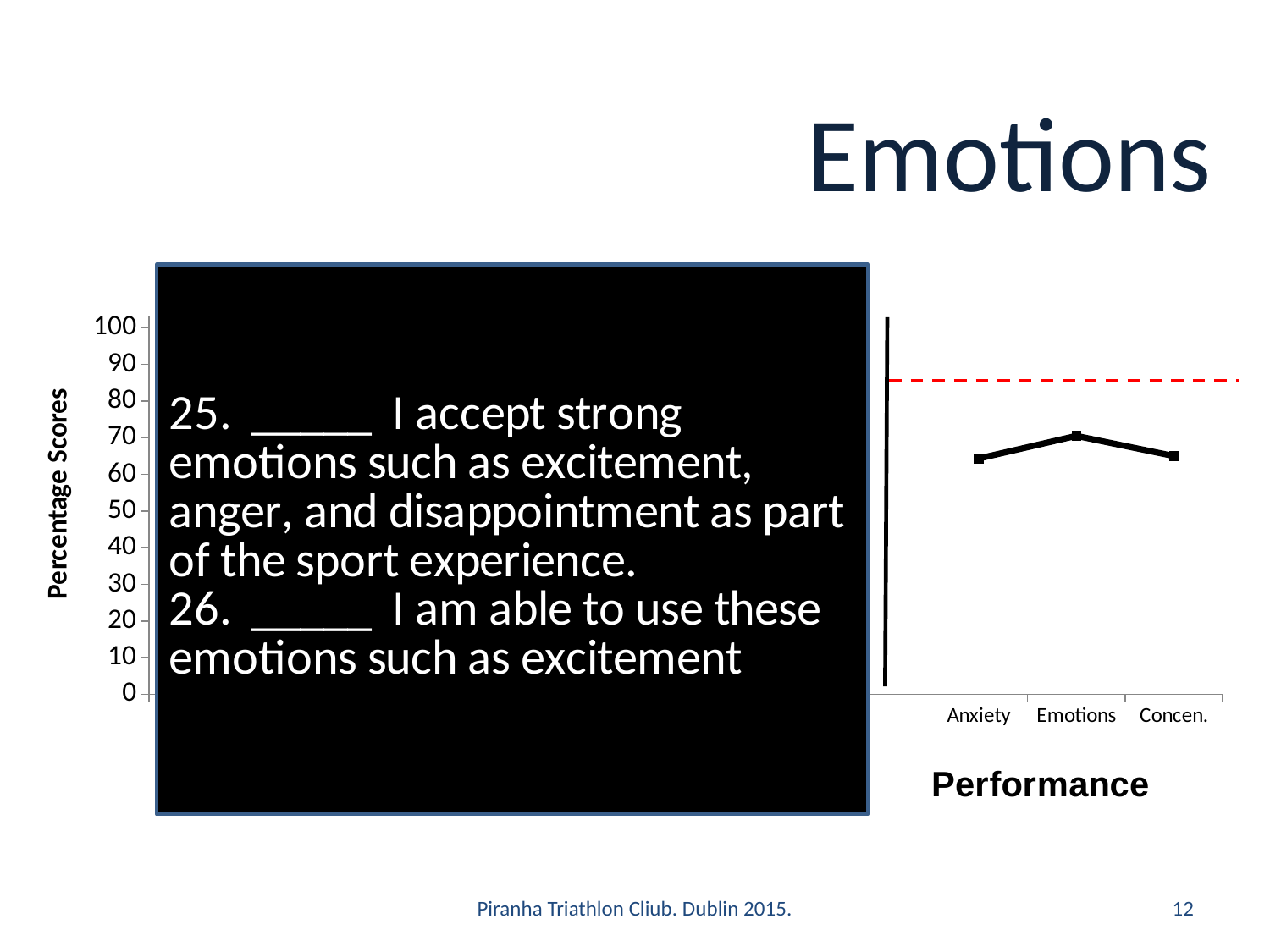
Is the value for Anxiety greater or less than 70? less Does the line rise or fall from Emotions to Concen.? fall Does the line rise or fall from Anxiety to Emotions? rise Which is larger, the value for Emotions or the value for Anxiety? Emotions What is the label of the vertical axis of the chart? Percentage Scores Among the visible categories Anxiety, Emotions and Concen., which has the highest value? Emotions What is the highest value shown on the vertical axis of the chart? 100 Is the value for Emotions greater or less than 80? less Is the value for Concen. greater or less than 80? less What kind of chart is shown on the slide? line chart Which is larger, the value for Emotions or the value for Concen.? Emotions